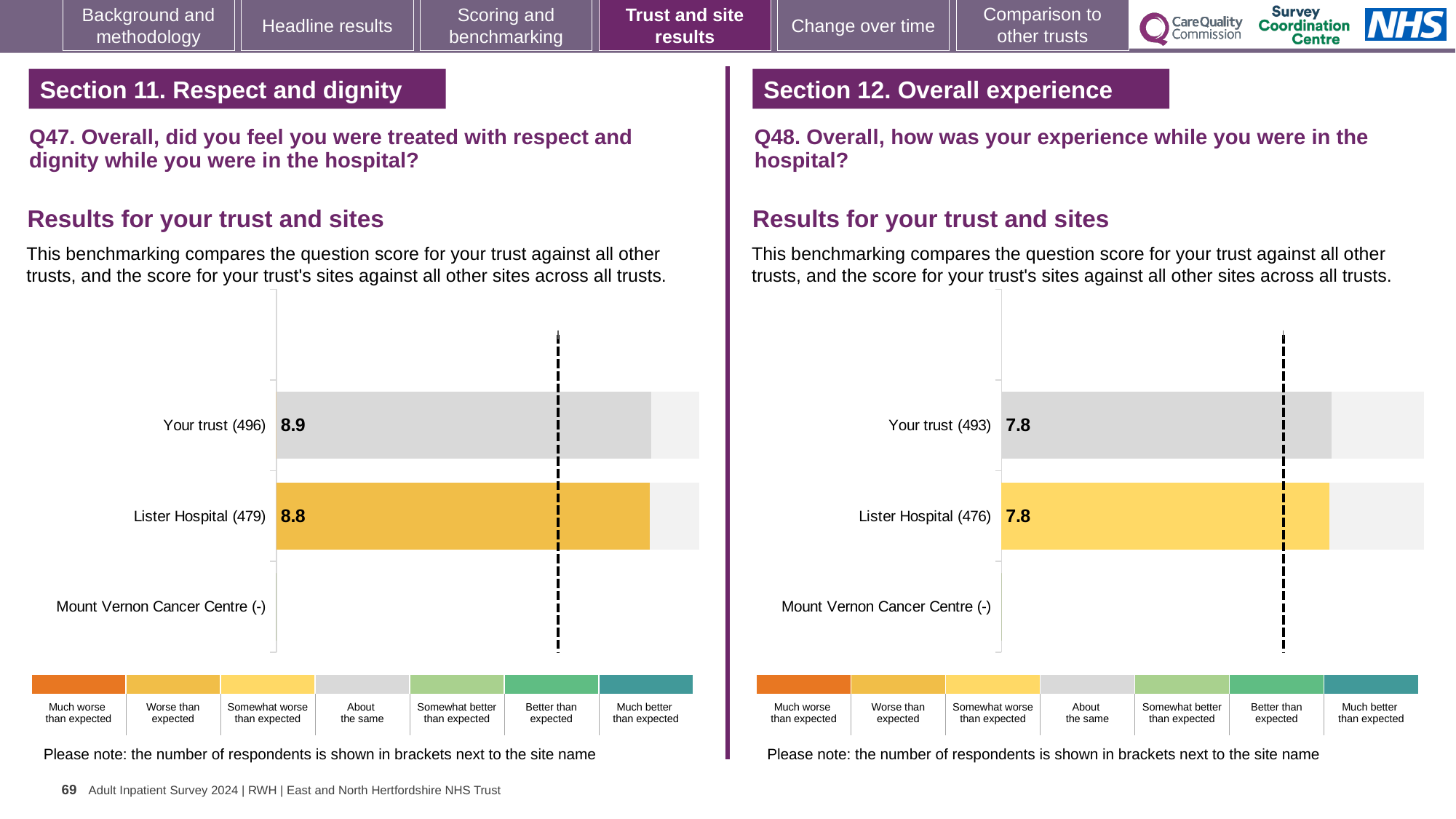
In the Q48 chart on the right, what is the score for Your trust? 7.8 In the Q47 chart on the left, how many respondents are shown in brackets for Your trust? 496 What kind of chart is used in the Q48 chart on the right? Bar chart In the Q48 chart on the right, what is the score for Lister Hospital? 7.8 In the Q48 chart on the right, how many respondents are shown in brackets for Your trust? 493 In the Q47 chart on the left, how many site/trust categories are listed on the vertical axis? 3 In the Q48 chart on the right, which category has no score shown? Mount Vernon Cancer Centre In the Q47 chart on the left, what is the score for Lister Hospital? 8.8 In the Q48 chart on the right, how many respondents are shown in brackets for Lister Hospital? 476 In the Q47 chart on the left, what is the score for Your trust? 8.9 In the Q47 chart on the left, which benchmark category does the colour of the Lister Hospital bar correspond to in the key? Worse than expected In the Q47 chart on the left, what is the difference between the Your trust score and the Lister Hospital score? 0.1